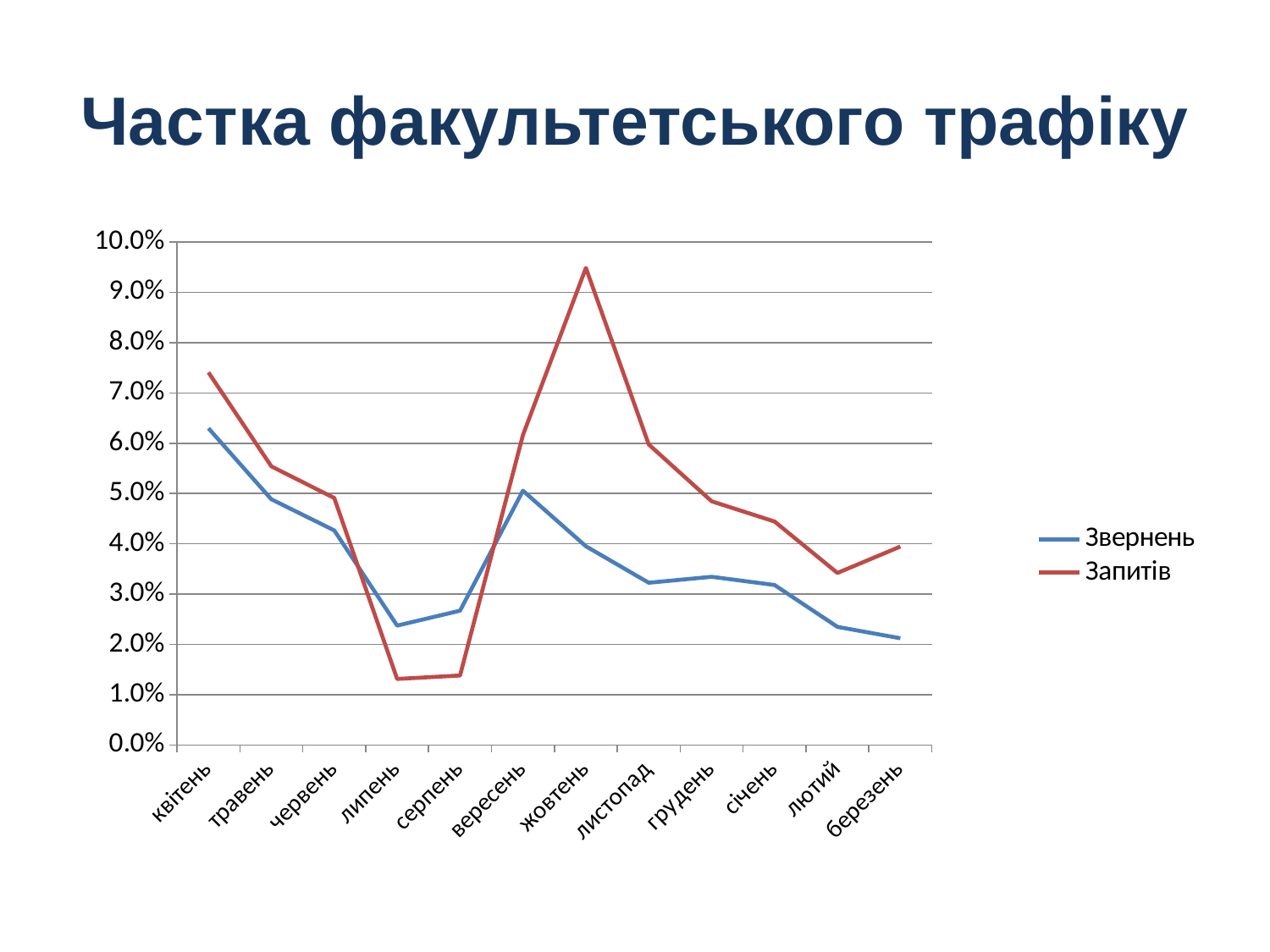
In which month does the Запитів series reach its highest value? жовтень Is the value of Запитів in жовтень greater or less than 9.0%? greater Does the Запитів series rise or fall from липень to жовтень? rise In which month does the Звернень series reach its highest value? квітень Is the value of Звернень in липень greater or less than 3.0%? less Is the value of Запитів in липень greater or less than 2.0%? less In липень, which series has the larger value, Звернень or Запитів? Звернень How many months are shown on the x axis? 12 What kind of chart is shown on the slide? line chart How many series does the legend list? 2 In жовтень, which series has the larger value, Звернень or Запитів? Запитів